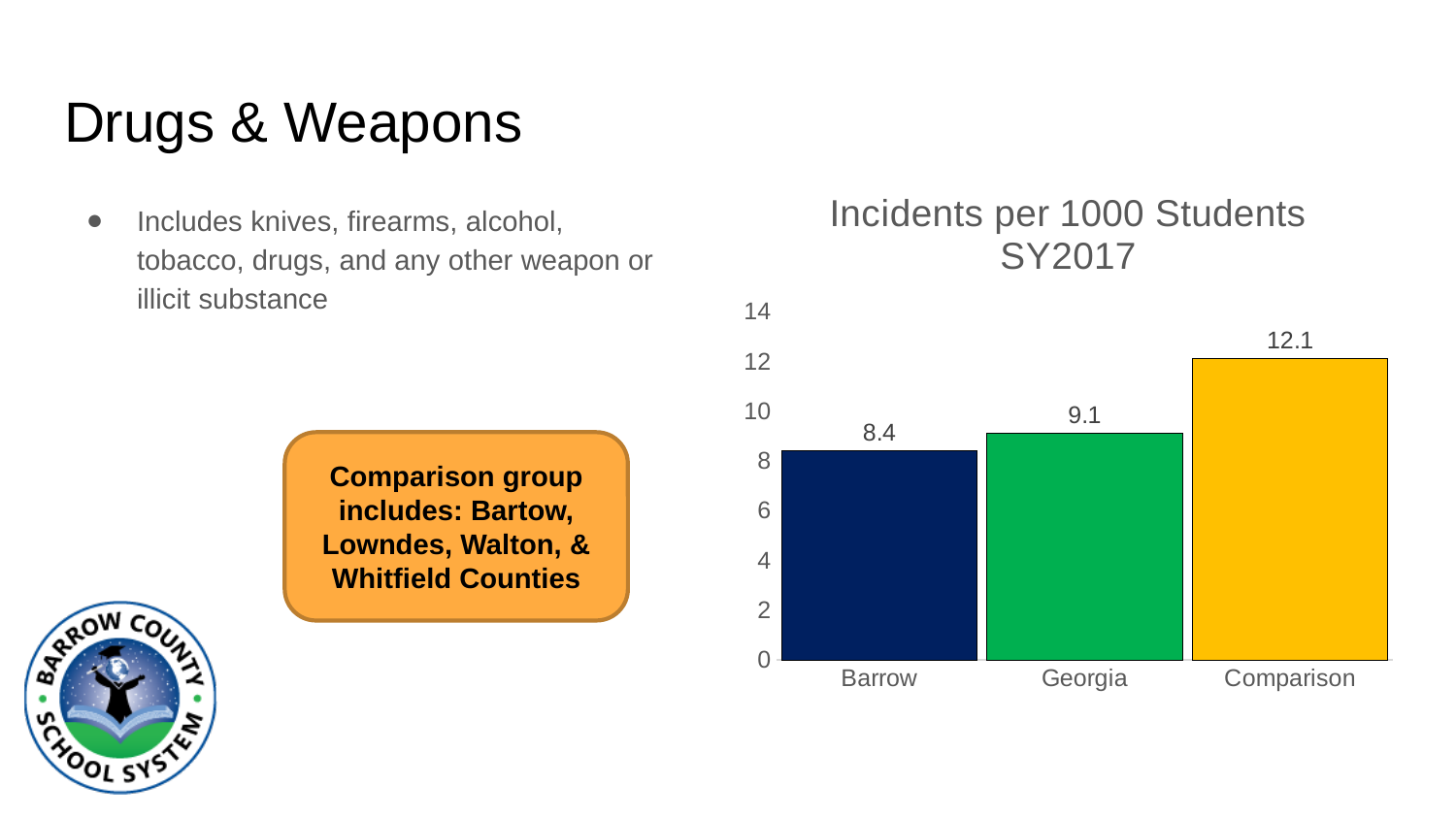
What is the title of the chart? Incidents per 1000 Students SY2017 Which category has the lowest value in the chart? Barrow What is the value for Barrow in the chart? 8.4 What is the difference between the Georgia value and the Barrow value? 0.7 Is the value for Comparison greater or less than 10? greater What is the difference between the Comparison value and the Barrow value? 3.7 What is the value for Comparison in the chart? 12.1 What is the value for Georgia in the chart? 9.1 What kind of chart is shown on the slide? bar chart Which is larger, the value for Georgia or the value for Barrow? Georgia How many categories are shown in the chart? 3 Which category has the highest value in the chart? Comparison